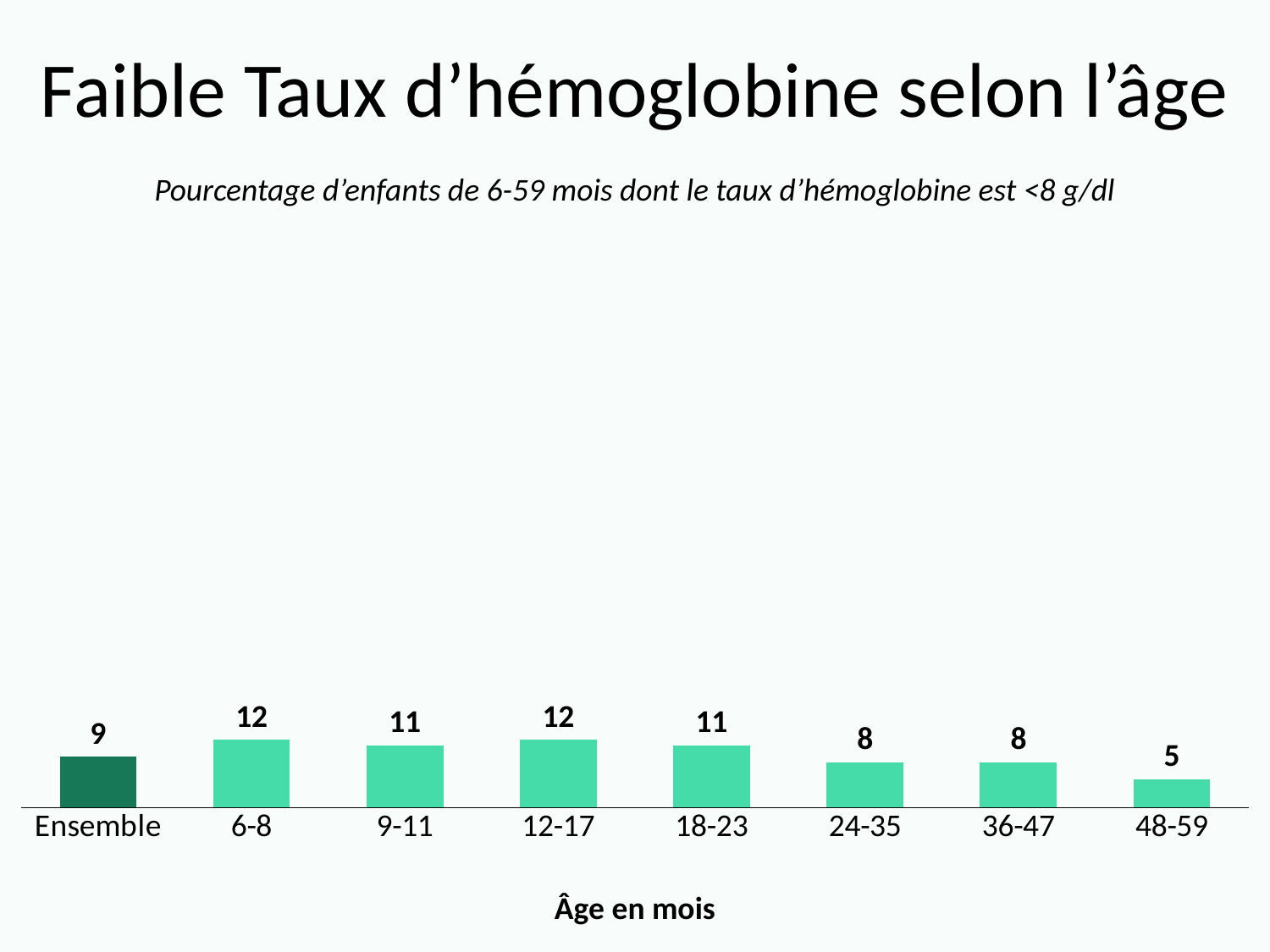
What is the x axis title of the chart? Âge en mois What kind of chart is shown on the slide? bar chart What is the value for the 24-35 months age group? 8 What is the value for the 6-8 months age group? 12 What is the difference between the values for 9-11 months and 36-47 months? 3 What is the value for the Ensemble category? 9 Which is larger, the value for 18-23 months or the value for 24-35 months? 18-23 How many categories are shown on the x axis? 8 Which age group has the lowest value? 48-59 Do the values generally rise or fall from the 12-17 months group to the 48-59 months group? fall What is the difference between the values for 6-8 months and 48-59 months? 7 What is the value for the 48-59 months age group? 5